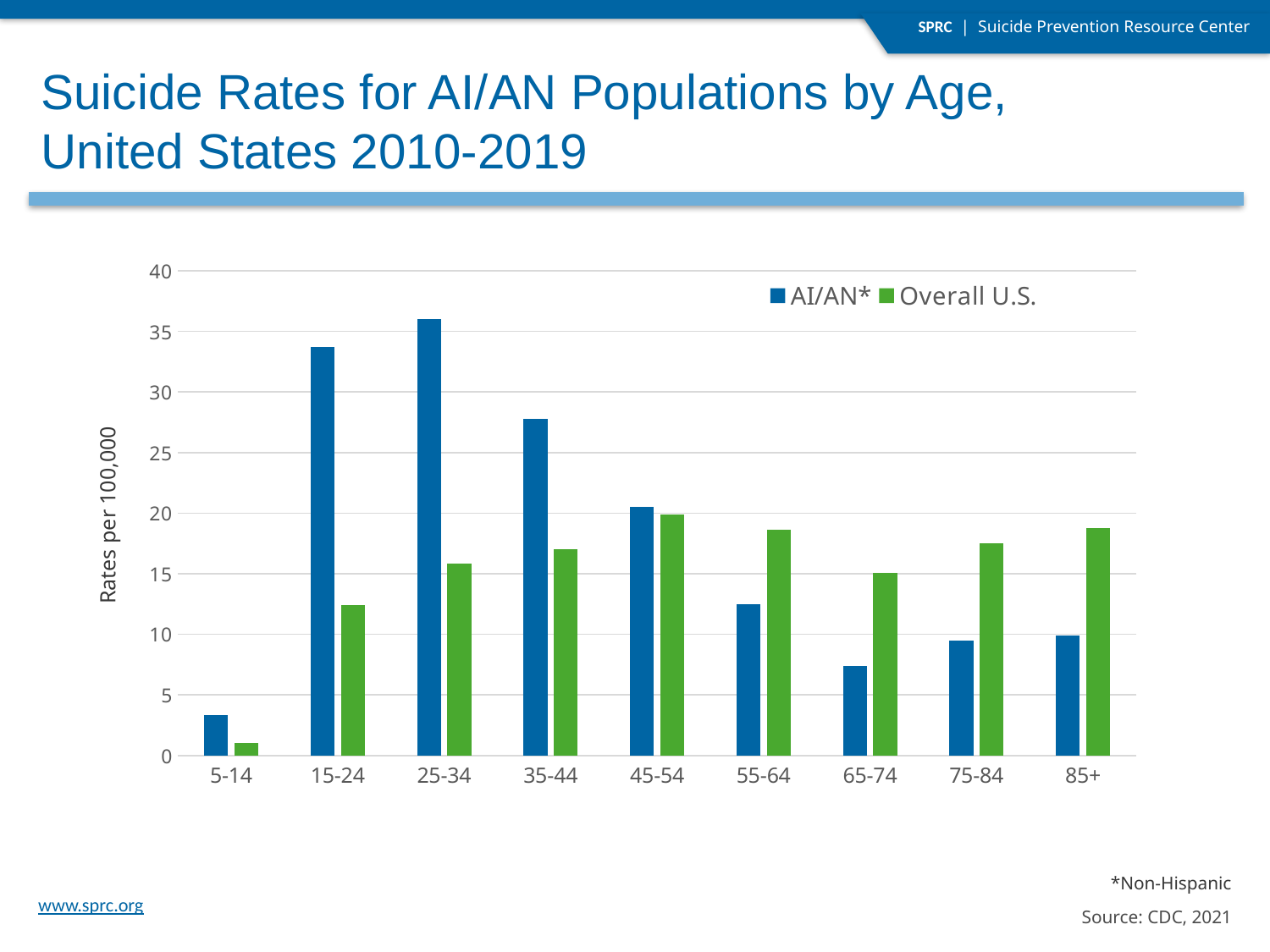
Is the AI/AN* rate for the 65-74 age group greater or less than 10? less How many series does the legend list? 2 Is the AI/AN* rate for the 25-34 age group greater or less than 35? greater What is the label of the y axis? Rates per 100,000 Which age group has the lowest Overall U.S. suicide rate? 5-14 What kind of chart is shown on the slide? bar chart For the 55-64 age group, which series has the larger value, AI/AN* or Overall U.S.? Overall U.S. For the 15-24 age group, which series has the larger value, AI/AN* or Overall U.S.? AI/AN* Which age group has the lowest AI/AN* suicide rate? 5-14 Is the Overall U.S. rate for the 85+ age group greater or less than 15? greater How many age groups are shown on the x axis? 9 Which age group has the highest AI/AN* suicide rate? 25-34